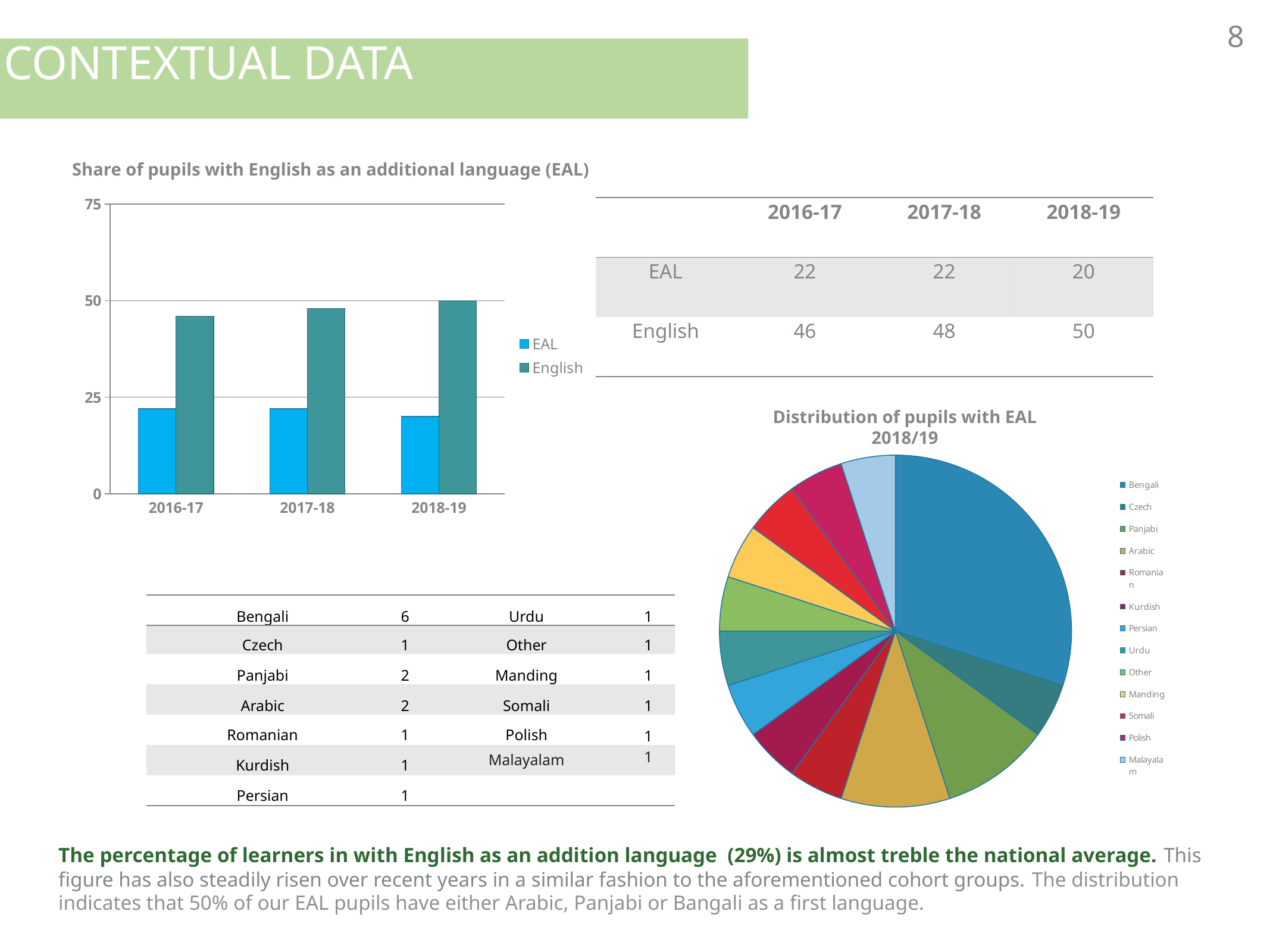
What type of chart is 'Share of pupils with English as an additional language (EAL)'? bar chart In the 'Distribution of pupils with EAL 2018/19' chart, which language has the largest slice? Bengali How many categories does the legend of the 'Distribution of pupils with EAL 2018/19' chart list? 13 In the 'Share of pupils with English as an additional language (EAL)' chart, what is the English value for 2017-18? 48 What type of chart is 'Distribution of pupils with EAL 2018/19'? pie chart In the 'Share of pupils with English as an additional language (EAL)' chart, is the English value for 2016-17 greater or less than 50? less How many series does the legend of the 'Share of pupils with English as an additional language (EAL)' chart list? 2 In the 'Share of pupils with English as an additional language (EAL)' chart, do the English values rise or fall from 2016-17 to 2018-19? rise In the 'Share of pupils with English as an additional language (EAL)' chart, what is the EAL value for 2018-19? 20 In the 'Share of pupils with English as an additional language (EAL)' chart, what is the difference between the English and EAL values for 2016-17? 24 In the 'Share of pupils with English as an additional language (EAL)' chart, which year has the highest English value? 2018-19